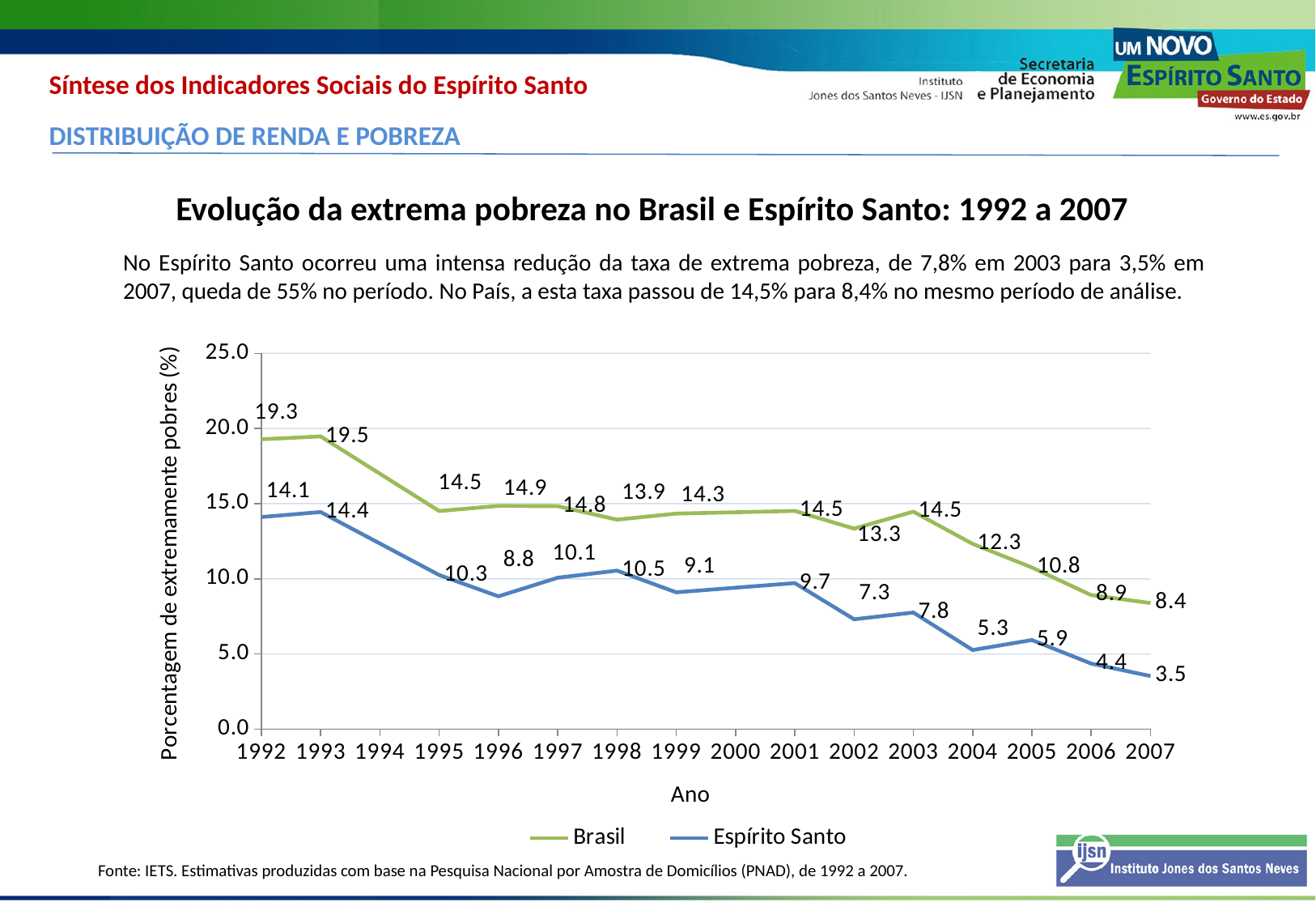
Is the value for Espírito Santo in 1996 greater or less than 10.0? less What is the value for Brasil in 1998? 13.9 In which year does the Brasil series reach its highest value? 1993 Overall, do the Espírito Santo values rise or fall from 1992 to 2007? fall What is the difference between the Brasil and Espírito Santo values in 1992? 5.2 What is the value for Espírito Santo in 2003? 7.8 What is the value for Brasil in 2007? 8.4 Which series has the higher value in 2005, Brasil or Espírito Santo? Brasil In which year does the Espírito Santo series reach its lowest value? 2007 How many series does the legend list? 2 What kind of chart is shown on the slide? line chart By how much did the Espírito Santo value fall from 2003 to 2007? 4.3